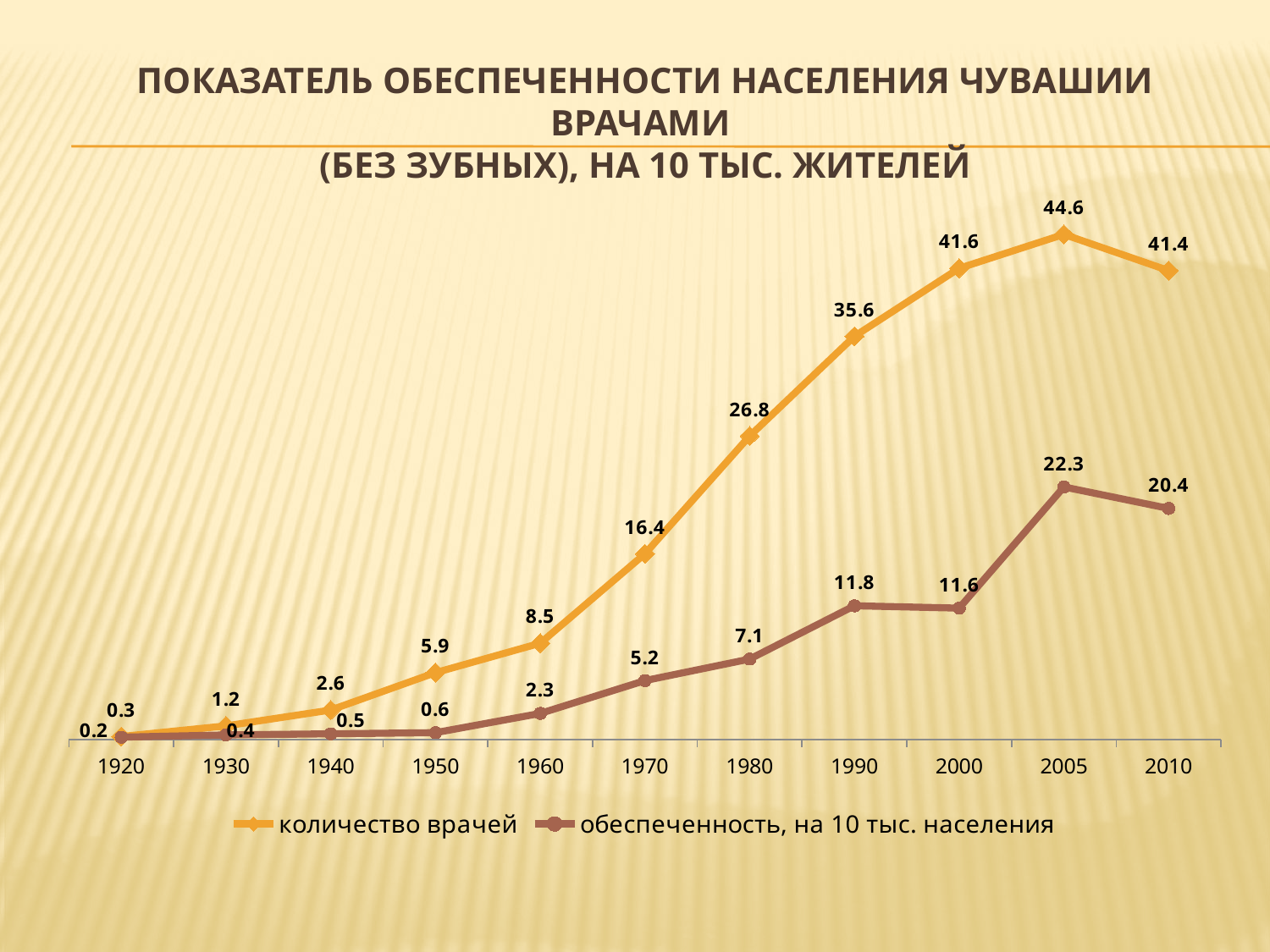
What is the difference between "количество врачей" in 2005 and in 2010? 3.2 What type of chart is shown on the slide? line chart How many years are plotted along the x axis? 11 What is the value of "количество врачей" in 1970? 16.4 Which is larger: "обеспеченность, на 10 тыс. населения" in 1990 or in 2000? 1990 What is the value of "количество врачей" in 2005? 44.6 What colour is the line for "количество врачей"? orange In which year is "обеспеченность, на 10 тыс. населения" at its lowest? 1920 In which year does "количество врачей" reach its highest value? 2005 Does "количество врачей" rise or fall between 1920 and 2005? rise How many series does the legend list? 2 What is the value of "обеспеченность, на 10 тыс. населения" in 1990? 11.8